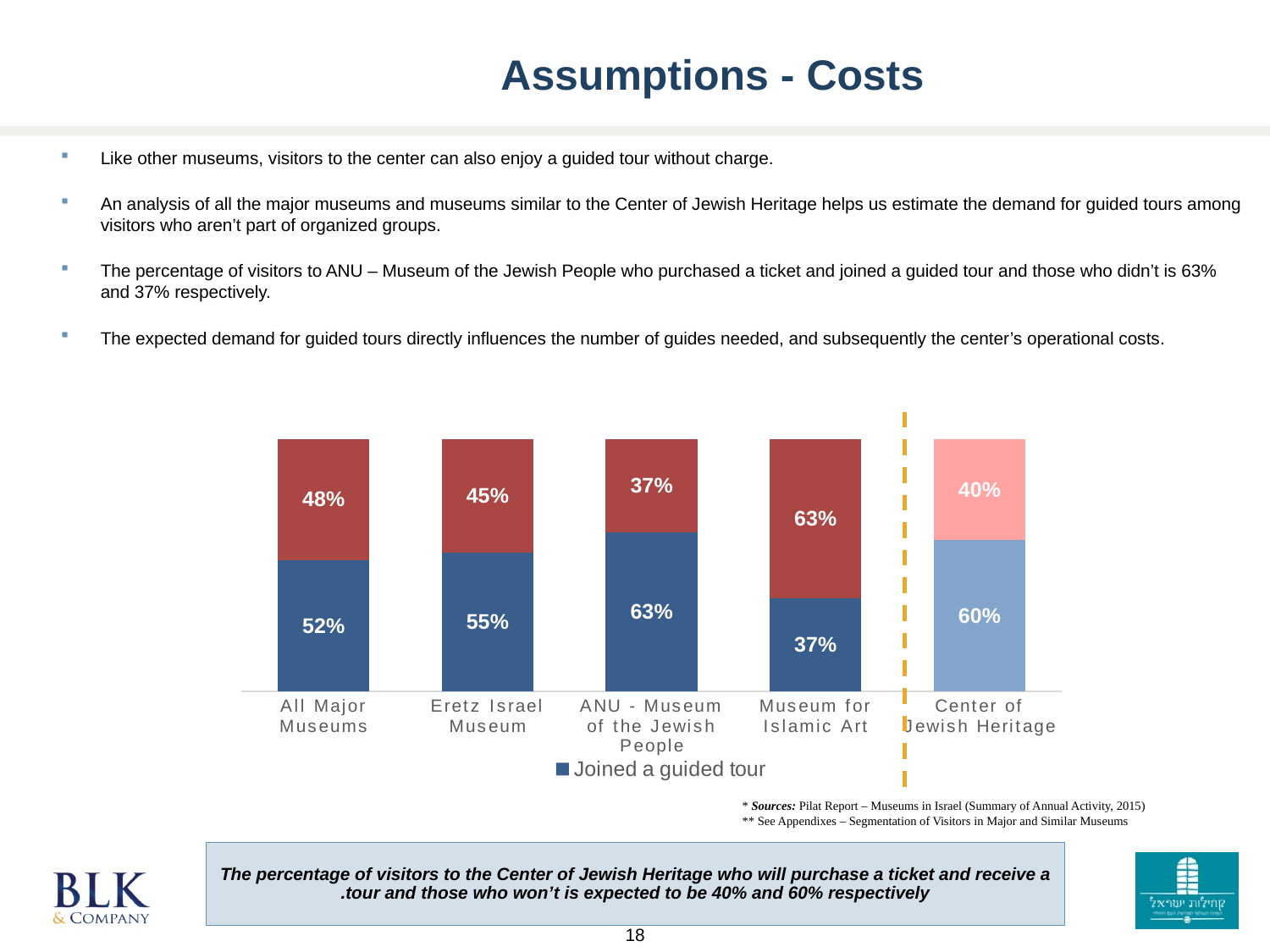
How many museum categories are shown on the x axis of the chart? 5 What is the total of the two segments in the bar for Museum for Islamic Art? 100% How many series does the chart's legend list? 1 Which museum has the lowest 'Joined a guided tour' value? Museum for Islamic Art What is the value of the top (upper) segment of the bar for Center of Jewish Heritage? 40% What is the 'Joined a guided tour' value for Eretz Israel Museum? 55% What kind of chart is shown on the slide? stacked bar chart What is the difference between the 'Joined a guided tour' values for Eretz Israel Museum and All Major Museums? 3% Which museum has the highest 'Joined a guided tour' value? ANU - Museum of the Jewish People What is the 'Joined a guided tour' value for ANU - Museum of the Jewish People? 63% What is the 'Joined a guided tour' value for All Major Museums? 52% What is the 'Joined a guided tour' value for Museum for Islamic Art? 37%